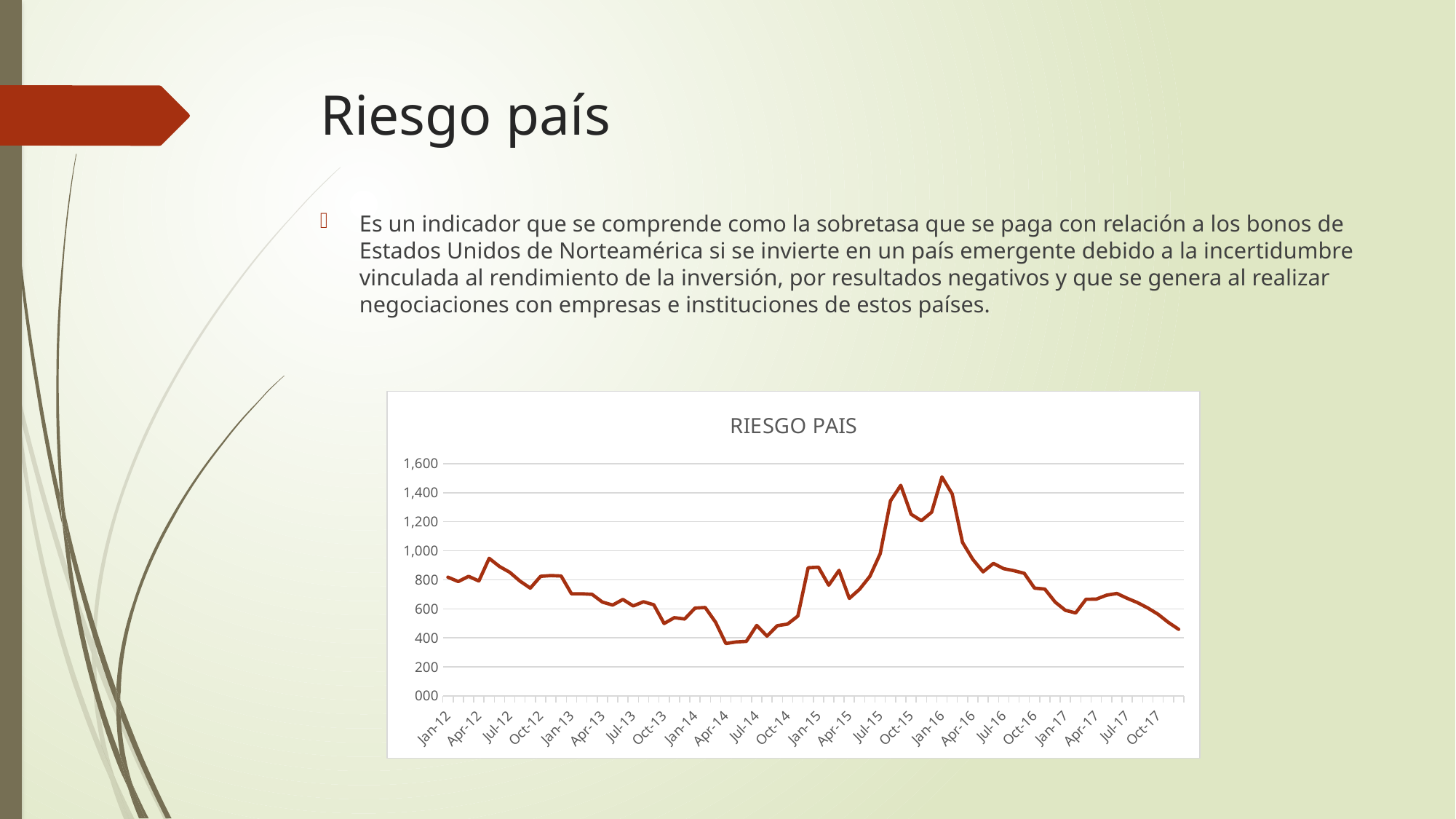
Is the value for Jan-12 greater or less than 600? greater What is the highest value shown on the vertical axis of the chart? 1,600 Is the value for Jan-17 greater or less than 800? less Which is larger, the value at Jan-16 or the value at Jan-12? Jan-16 Around which month does the RIESGO PAIS line reach its lowest value? Apr-14 What kind of chart is shown on the slide? Line chart Is the value for Apr-14 greater or less than 600? less Does the RIESGO PAIS line rise or fall from Jan-16 to the end of the series? fall Around which month does the RIESGO PAIS line reach its highest value? Jan-16 What is the title of the chart on the slide? RIESGO PAIS